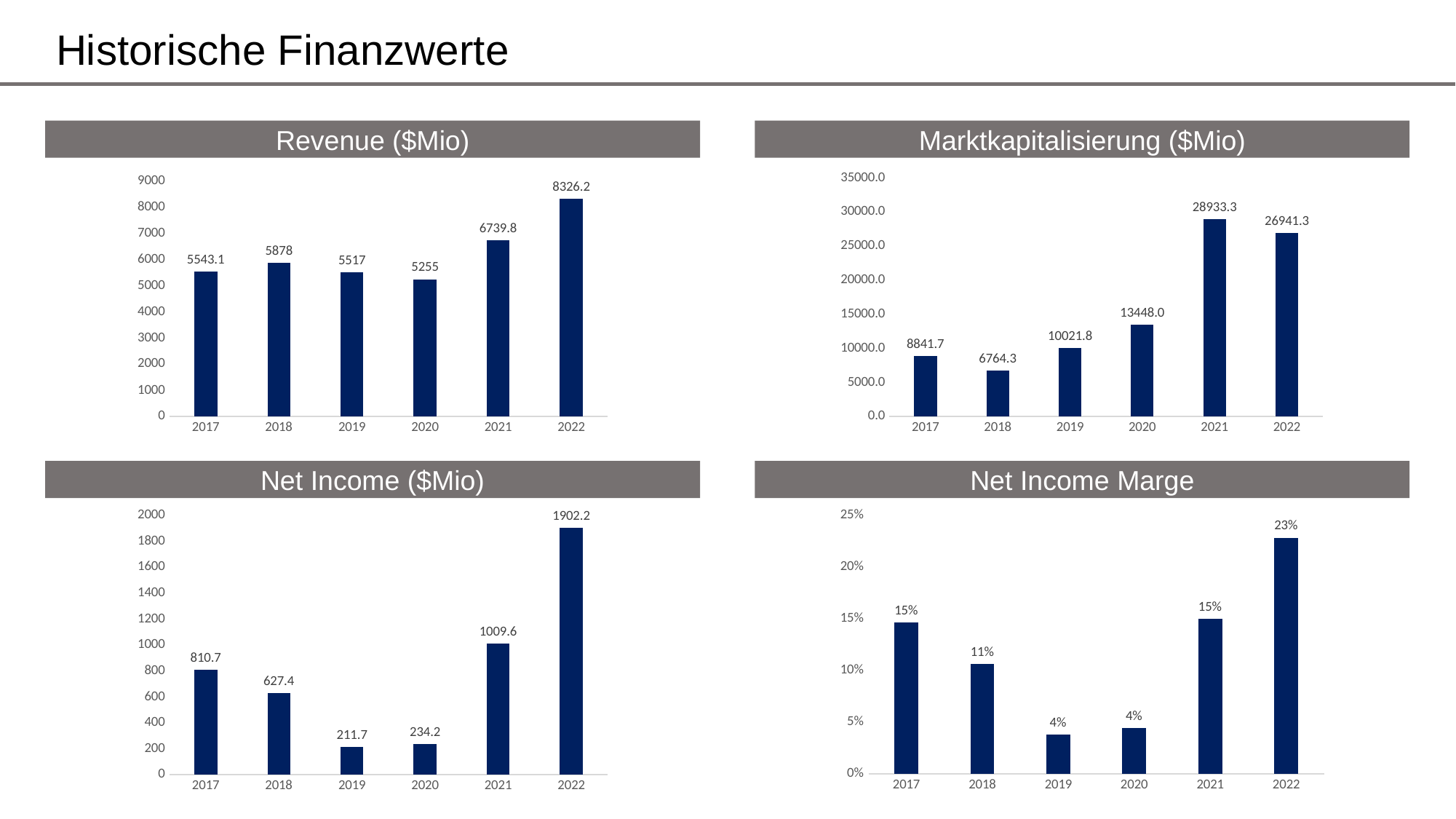
What kind of chart is the Net Income Marge chart? bar chart In the Net Income ($Mio) chart, how many years are shown on the x axis? 6 In the Revenue ($Mio) chart, what is the difference between the 2022 and 2021 values? 1586.4 In the Revenue ($Mio) chart, what is the value for 2020? 5255 In the Marktkapitalisierung ($Mio) chart, which year has the lowest value? 2018 In the Net Income ($Mio) chart, what is the difference between the 2017 and 2018 values? 183.3 In the Marktkapitalisierung ($Mio) chart, what is the value for 2019? 10021.8 In the Net Income Marge chart, is the value for 2018 greater or less than 10%? greater In the Revenue ($Mio) chart, which year has the highest revenue? 2022 In the Net Income ($Mio) chart, what is the value for 2019? 211.7 In the Net Income Marge chart, what is the value for 2022? 23% In the Marktkapitalisierung ($Mio) chart, which is larger, the value for 2021 or 2022? 2021